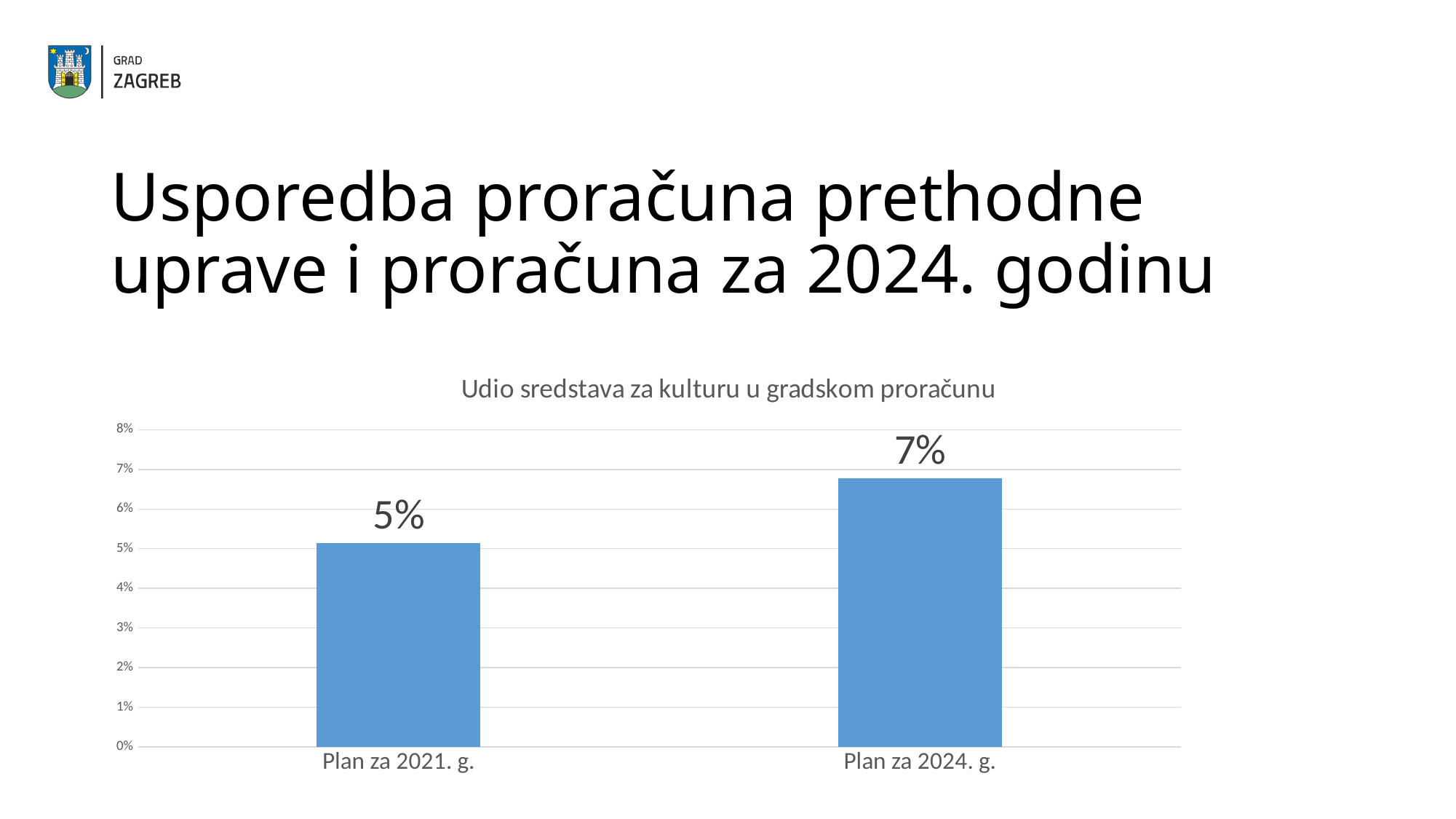
How many categories are shown on the x axis? 2 What is the difference between the labelled values for Plan za 2024. g. and Plan za 2021. g.? 2% What kind of chart is shown on the slide? Bar chart Is the bar for Plan za 2021. g. greater or less than 4%? greater Do the values rise or fall from Plan za 2021. g. to Plan za 2024. g.? Rise What is the value shown for Plan za 2021. g.? 5% Which category has the highest value? Plan za 2024. g. What is the title of the chart? Udio sredstava za kulturu u gradskom proračunu Is the bar for Plan za 2024. g. greater or less than 8%? less What is the value shown for Plan za 2024. g.? 7% Which is larger, the value for Plan za 2021. g. or the value for Plan za 2024. g.? Plan za 2024. g. Which category has the lowest value? Plan za 2021. g.